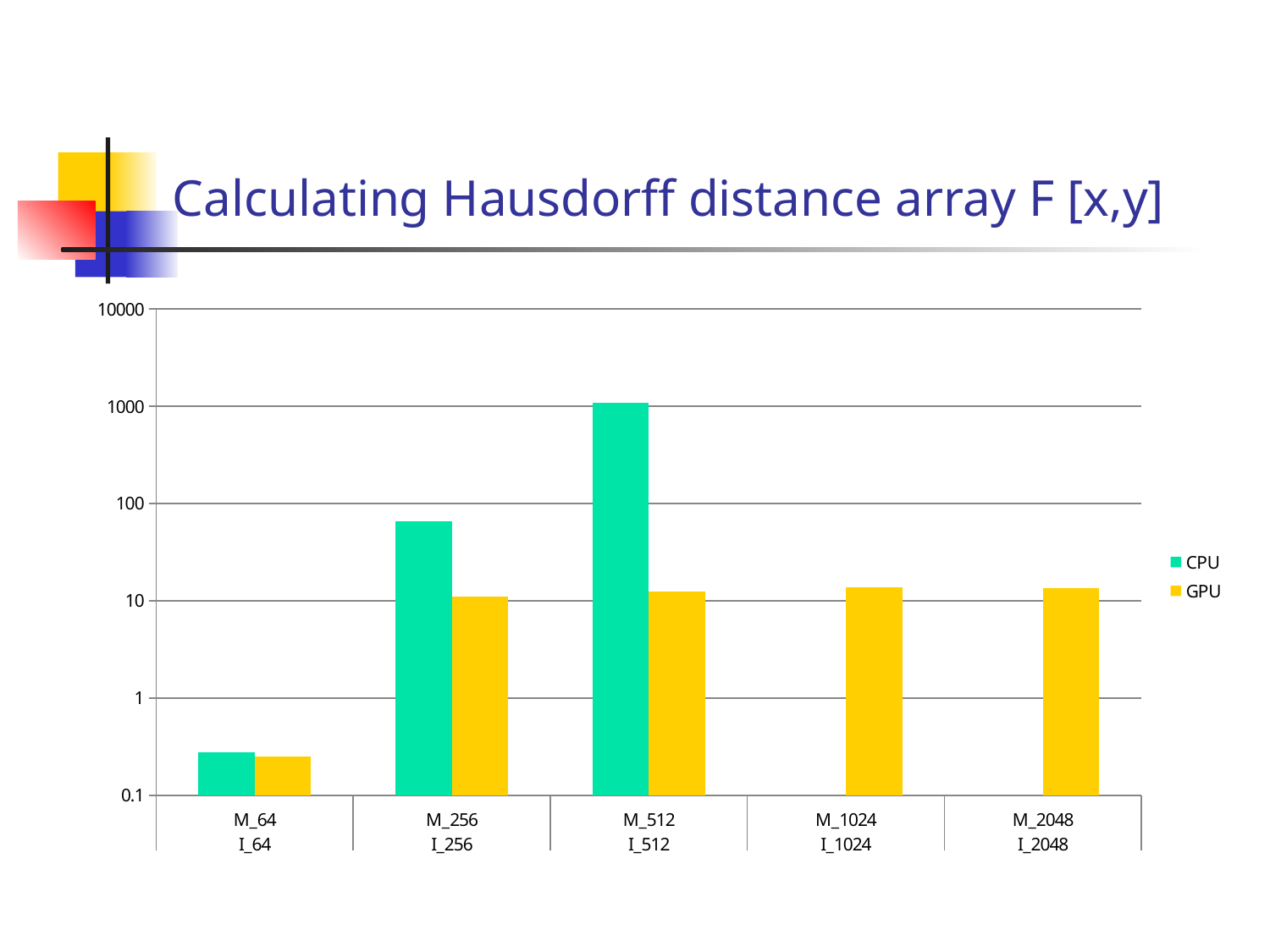
Do the CPU values rise or fall from M_64 I_64 to M_512 I_512? rise For M_512 I_512, which is larger, the CPU value or the GPU value? CPU How many categories are shown on the x axis? 5 How many series does the legend list? 2 Which category has the lowest GPU value? M_64 I_64 What kind of chart is shown on the slide? bar chart Is the GPU value for M_1024 I_1024 greater or less than 10? greater Is the CPU value for M_256 I_256 greater or less than 100? less What is the title of the slide containing the chart? Calculating Hausdorff distance array F [x,y] Which category has the highest CPU value? M_512 I_512 Is the GPU value for M_64 I_64 greater or less than 1? less